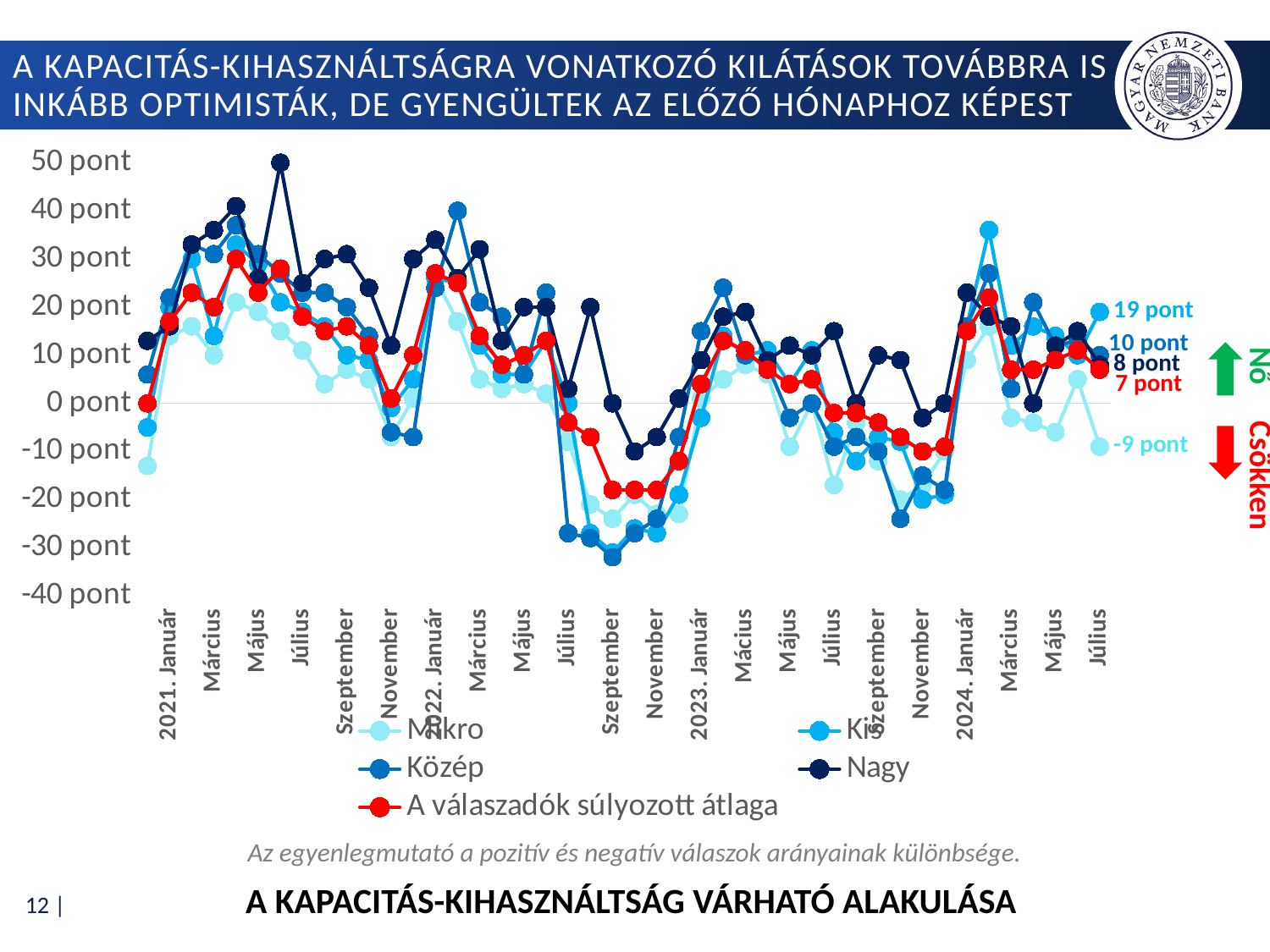
What is the title of the chart shown at the bottom of the slide? A KAPACITÁS-KIHASZNÁLTSÁG VÁRHATÓ ALAKULÁSA Is the value for the Nagy series in 2021 Május greater or less than 40 pont? less What is the value for 'A válaszadók súlyozott átlaga' at the last point (2024 Július)? 7 pont What is the difference between the Kis and Mikro values at the last point (2024 Július)? 28 pont What is the value for the Közép series at the last point (2024 Július)? 10 pont Which series has the highest value at the last point (2024 Július)? Kis What is the value for the Nagy series at the last point (2024 Július)? 8 pont What is the value for the Mikro series at the last point (2024 Július)? -9 pont Which series has the lowest value at the last point (2024 Július)? Mikro How many series does the legend list? 5 What kind of chart is shown on the slide? line chart What is the value for the Kis series at the last point (2024 Július)? 19 pont